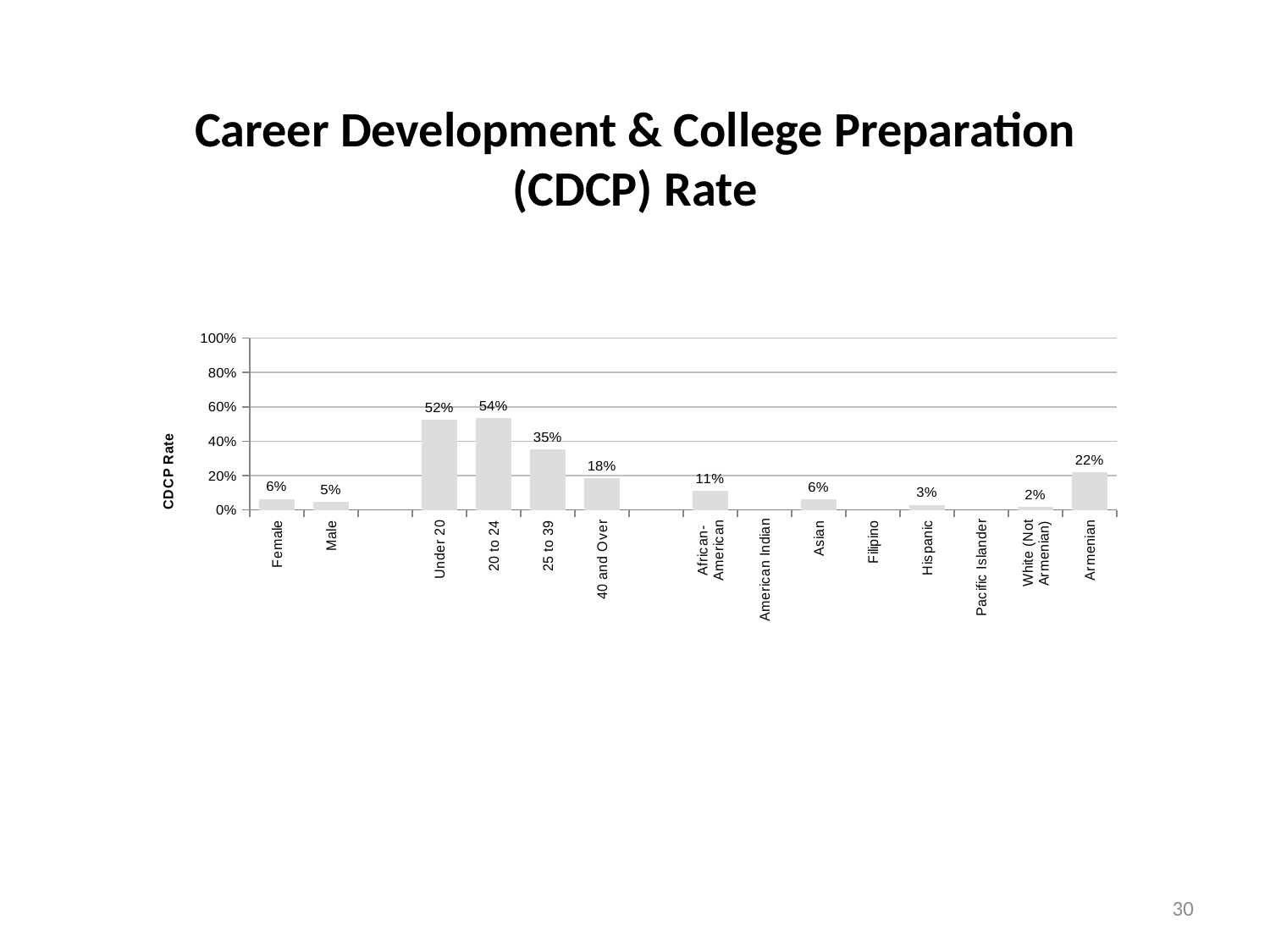
What is the CDCP rate for Female? 6% What is the difference between the CDCP rates for Armenian and White (Not Armenian)? 20% What is the CDCP rate for Armenian? 22% Is the CDCP rate for 20 to 24 greater or less than 40%? greater What is the CDCP rate for the 25 to 39 age group? 35% What is the CDCP rate for Hispanic? 3% What is the title of the chart's vertical axis? CDCP Rate What is the difference between the CDCP rates for Under 20 and 40 and Over? 34% Which has a higher CDCP rate, African-American or Asian? African-American Which category has the highest CDCP rate? 20 to 24 What kind of chart is shown on the slide? bar chart Which age group has the lowest CDCP rate? 40 and Over